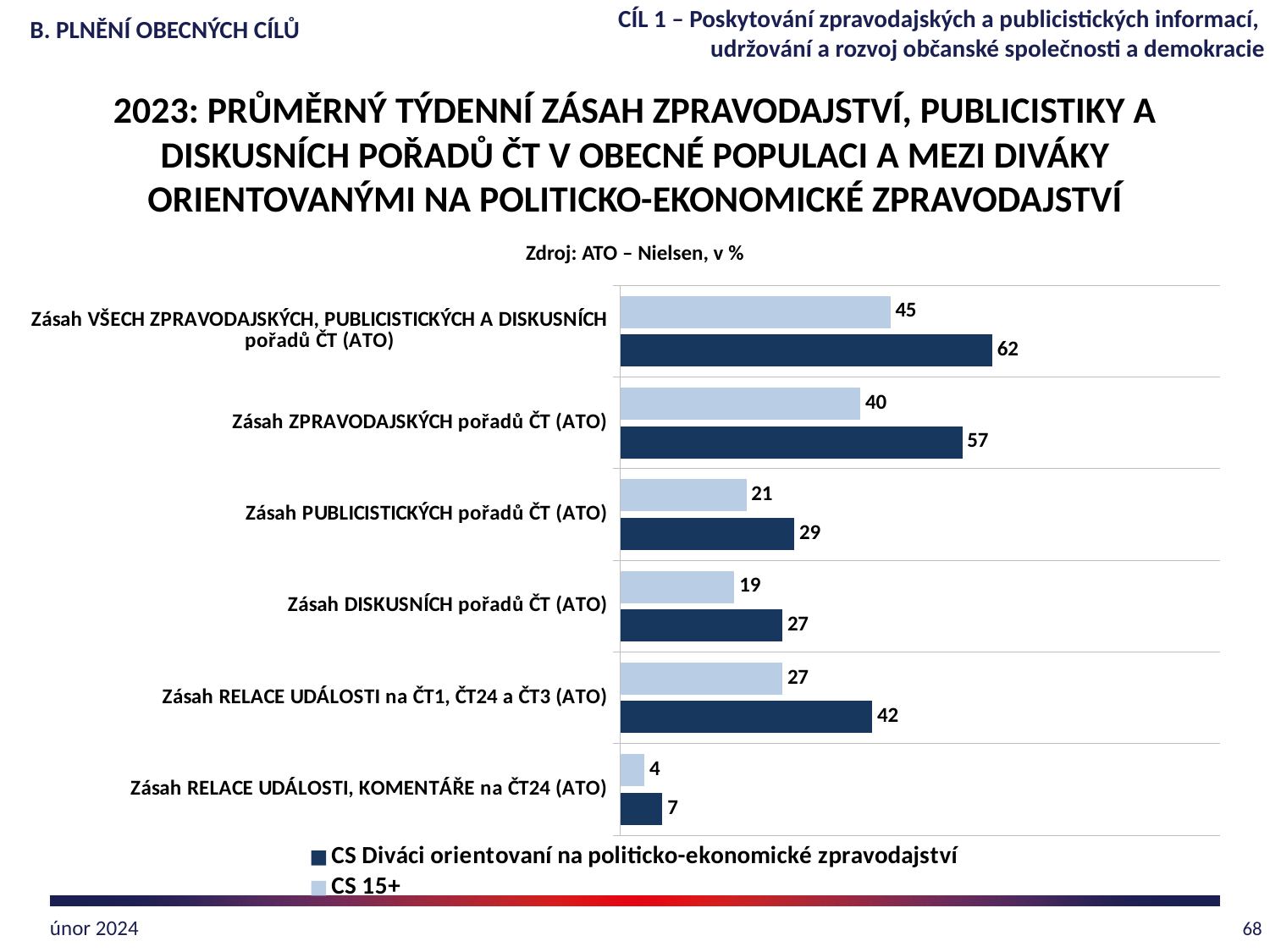
How many series does the legend list? 2 What kind of chart is shown on the slide? Bar chart What is the value for 'CS Diváci orientovaní na politicko-ekonomické zpravodajství' for 'Zásah PUBLICISTICKÝCH pořadů ČT (ATO)'? 29 What is the value for 'CS Diváci orientovaní na politicko-ekonomické zpravodajství' for 'Zásah RELACE UDÁLOSTI na ČT1, ČT24 a ČT3 (ATO)'? 42 Which category has the highest value for 'CS Diváci orientovaní na politicko-ekonomické zpravodajství'? Zásah VŠECH ZPRAVODAJSKÝCH, PUBLICISTICKÝCH A DISKUSNÍCH pořadů ČT (ATO) What is the value for CS 15+ for 'Zásah ZPRAVODAJSKÝCH pořadů ČT (ATO)'? 40 How many categories are shown in the chart? 6 What is the value for CS 15+ for 'Zásah RELACE UDÁLOSTI, KOMENTÁŘE na ČT24 (ATO)'? 4 Which category has the lowest value for CS 15+? Zásah RELACE UDÁLOSTI, KOMENTÁŘE na ČT24 (ATO) What is the difference between the two series for 'Zásah VŠECH ZPRAVODAJSKÝCH, PUBLICISTICKÝCH A DISKUSNÍCH pořadů ČT (ATO)'? 17 Which is larger for CS 15+: 'Zásah PUBLICISTICKÝCH pořadů ČT (ATO)' or 'Zásah RELACE UDÁLOSTI na ČT1, ČT24 a ČT3 (ATO)'? Zásah RELACE UDÁLOSTI na ČT1, ČT24 a ČT3 (ATO) What is the difference between the CS 15+ values for 'Zásah ZPRAVODAJSKÝCH pořadů ČT (ATO)' and 'Zásah DISKUSNÍCH pořadů ČT (ATO)'? 21